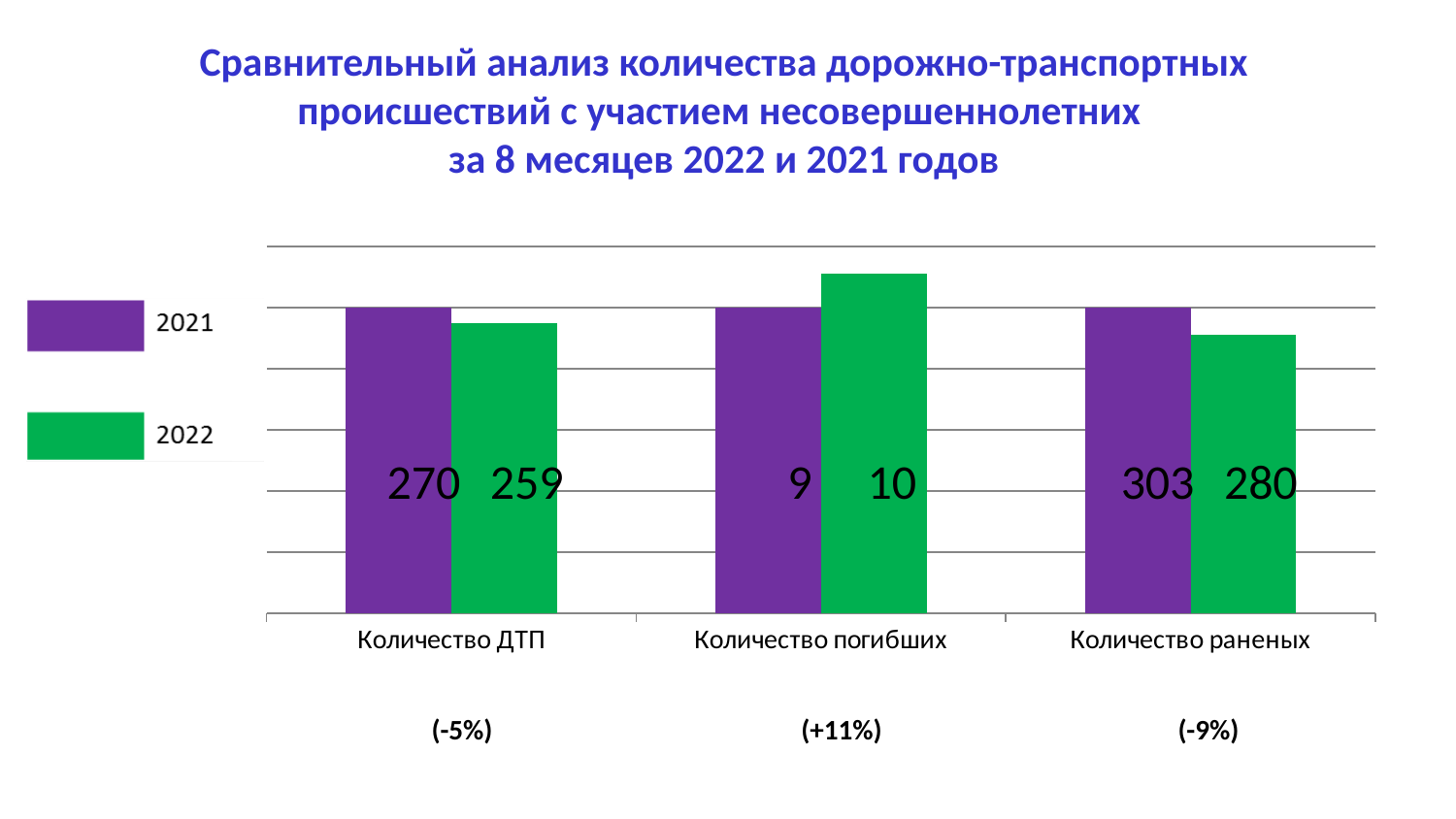
What is the value for 2022 in the category Количество раненых? 280 How many series does the legend list? 2 What is the value for 2022 in the category Количество погибших? 10 Which category has the lowest 2021 value? Количество погибших How many categories are shown on the x axis? 3 What is the difference between the 2021 and 2022 values for Количество ДТП? 11 What is the value for 2021 in the category Количество ДТП? 270 What kind of chart is shown on the slide? Bar chart What is the value for 2021 in the category Количество раненых? 303 Which is larger for Количество погибших: the 2021 value or the 2022 value? 2022 What is the difference between the 2021 and 2022 values for Количество раненых? 23